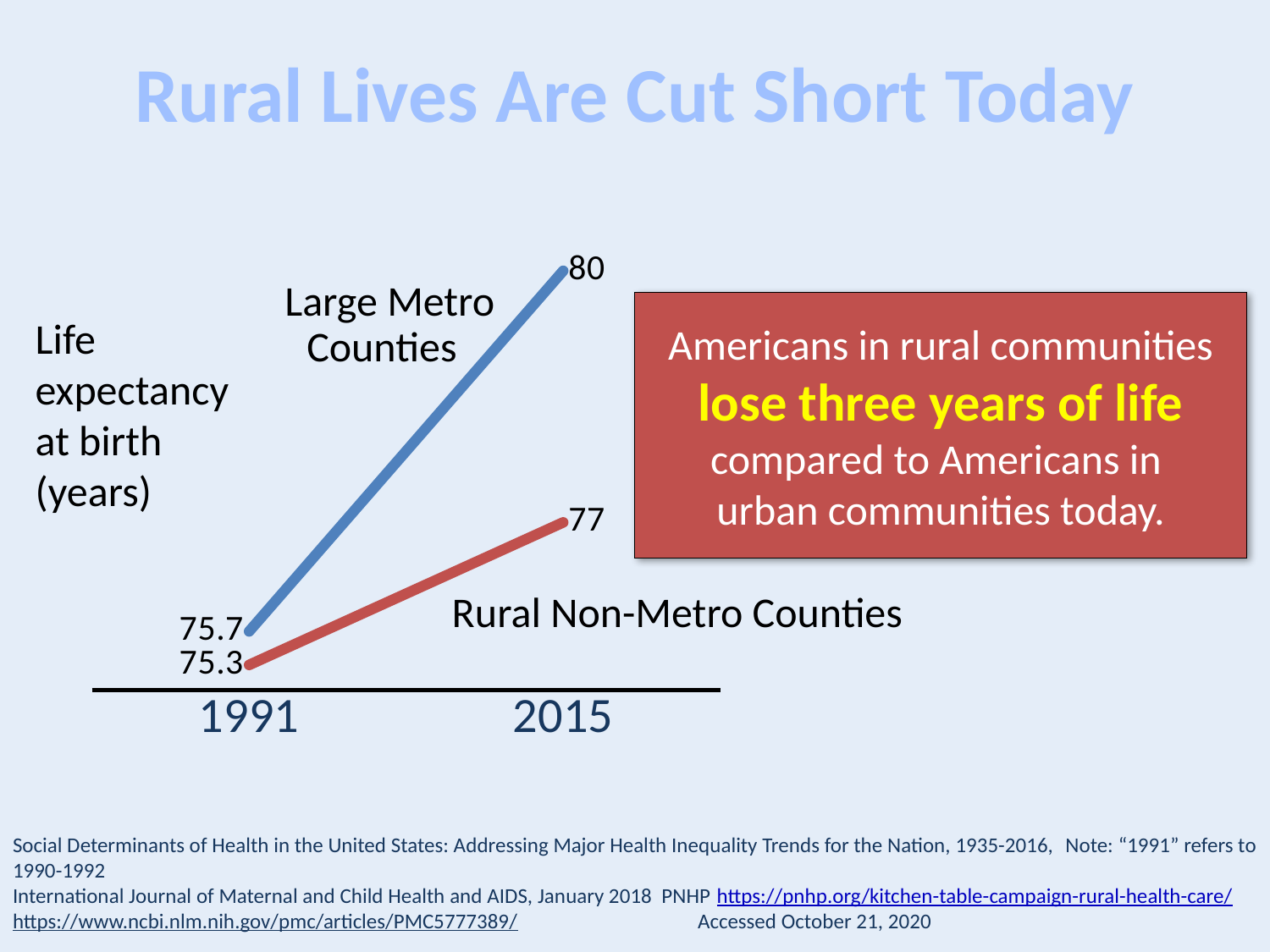
What is the life expectancy at birth for Rural Non-Metro Counties in 2015? 77 What colour is the line for Rural Non-Metro Counties? red By how much did life expectancy in Rural Non-Metro Counties increase from 1991 to 2015? 1.7 What is the life expectancy at birth for Large Metro Counties in 2015? 80 What is the life expectancy at birth for Rural Non-Metro Counties in 1991? 75.3 Does life expectancy for Rural Non-Metro Counties rise or fall from 1991 to 2015? rise By how much did life expectancy in Large Metro Counties increase from 1991 to 2015? 4.3 What is the difference in life expectancy between Large Metro Counties and Rural Non-Metro Counties in 2015? 3 What is the life expectancy at birth for Large Metro Counties in 1991? 75.7 What kind of chart is shown on the slide? line chart Which series has the higher life expectancy in 2015, Large Metro Counties or Rural Non-Metro Counties? Large Metro Counties How many series are plotted on the chart? 2